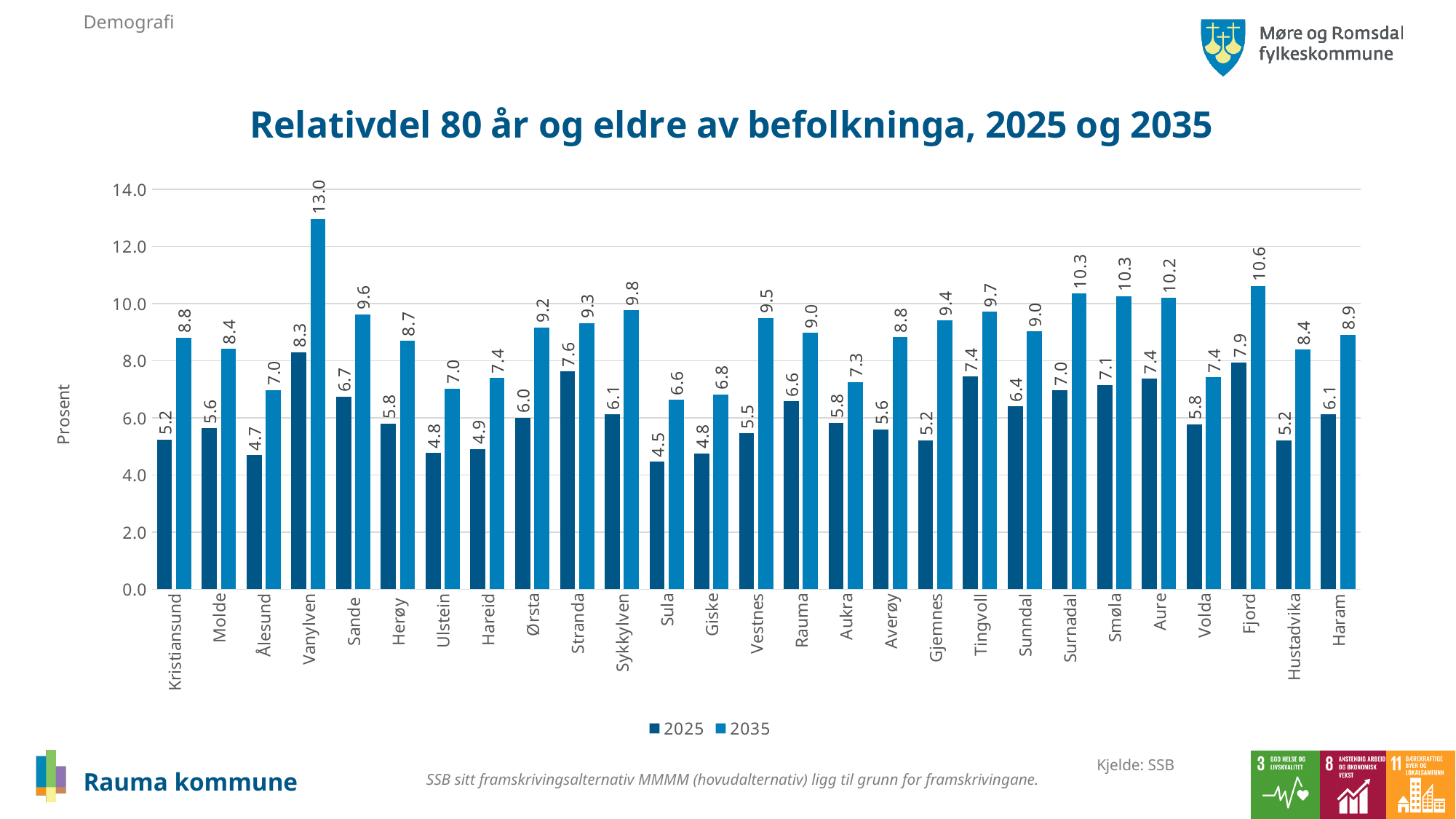
What is the 2025 value for Rauma? 6.6 Which municipality has the highest 2035 value? Vanylven Which municipality has the lowest 2035 value? Sula Which municipality has the lowest 2025 value? Sula What is the difference between the 2035 and 2025 values for Rauma? 2.4 What is the 2035 value for Vanylven? 13.0 What is the label on the y axis? Prosent How many series does the legend list? 2 What is the 2035 value for Fjord? 10.6 What kind of chart is shown? Bar chart How many municipalities are shown on the x axis? 27 Which is larger, the 2025 value for Stranda or the 2025 value for Tingvoll? Stranda